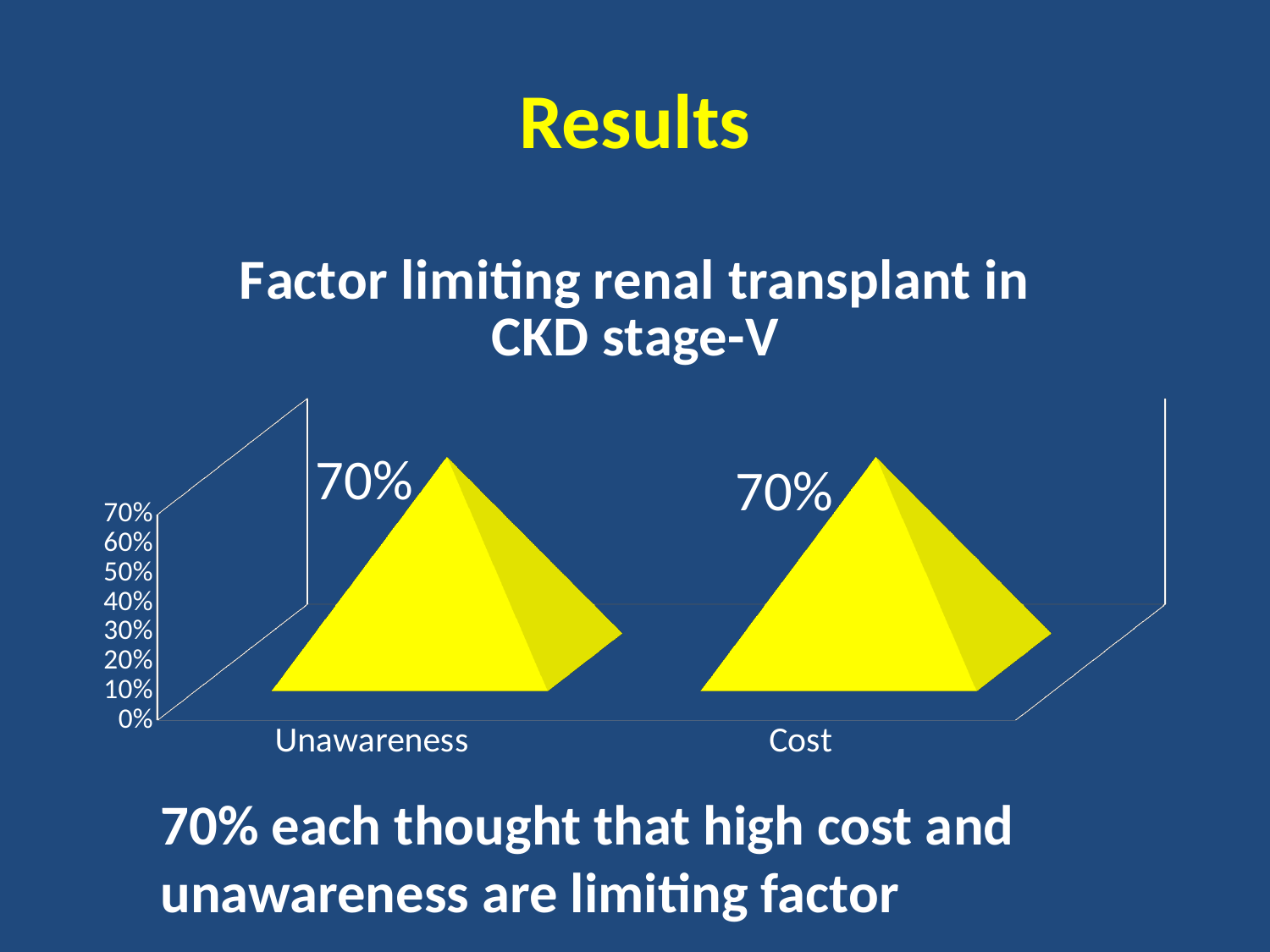
What is the title of the chart? Factor limiting renal transplant in CKD stage-V Do the values for Unawareness and Cost differ, or are they the same? the same How many categories are shown on the x axis of the chart? 2 What is the value for Unawareness? 70% What is the value for Cost? 70% What is the highest value shown on the vertical axis of the chart? 70% Is the value for Unawareness greater or less than 40%? greater What kind of chart is shown on the slide? bar chart Is the value for Cost greater or less than 50%? greater What is the difference between the values for Unawareness and Cost? 0%